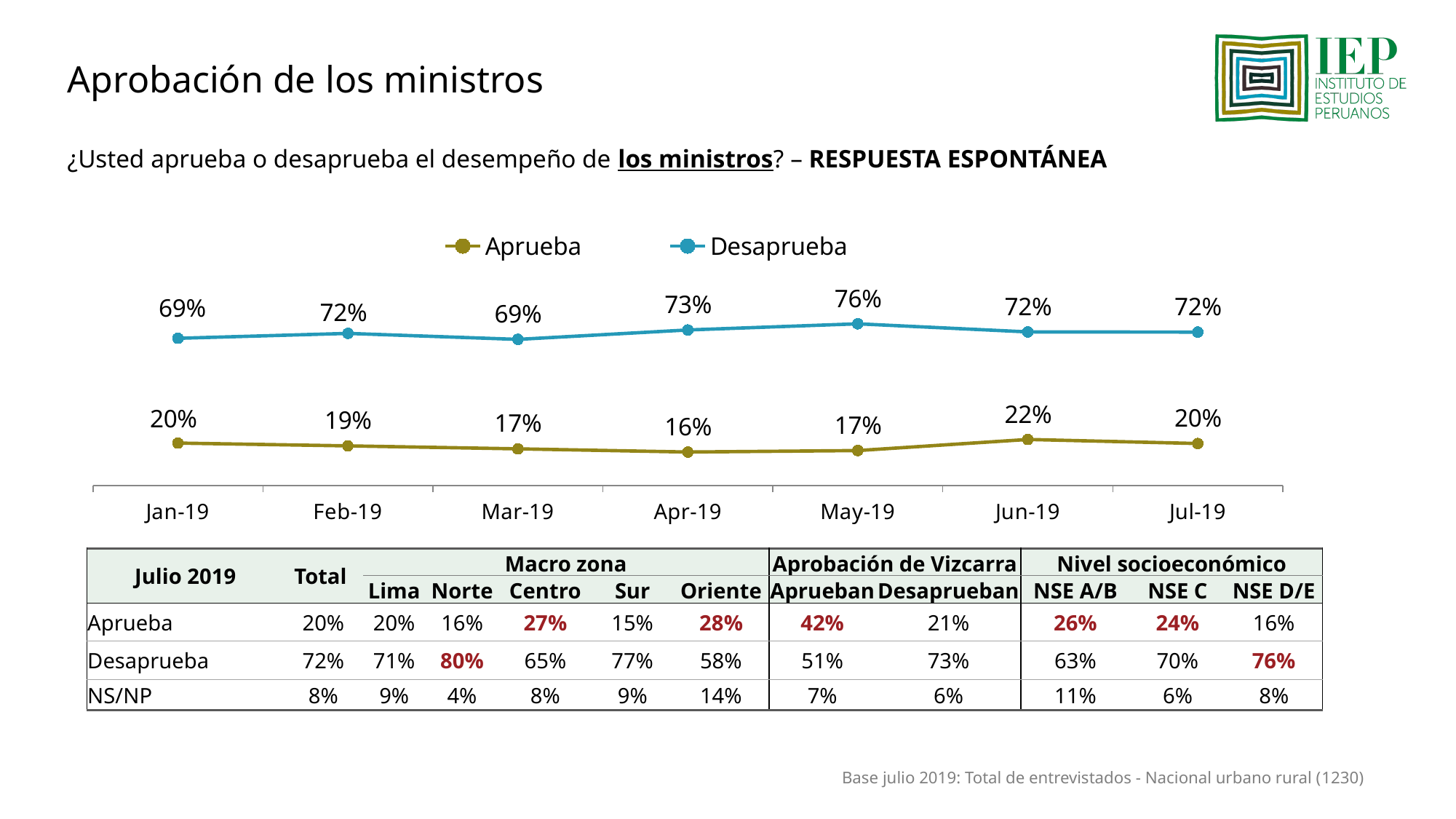
What is the Desaprueba value for May-19? 76% In which month is the Aprueba series lowest? Apr-19 Does the Aprueba series rise or fall from Jan-19 to Apr-19? Fall What kind of chart is shown on the slide? Line chart What is the Aprueba value for Jun-19? 22% How many months are shown on the x axis of the chart? 7 Which is larger in Jan-19, the Aprueba value or the Desaprueba value? Desaprueba What is the Aprueba value for Apr-19? 16% How many series does the legend list? 2 In which month is the Desaprueba series highest? May-19 What colour is the Desaprueba line in the chart? Blue What is the difference between the Desaprueba and Aprueba values in Jul-19? 52%